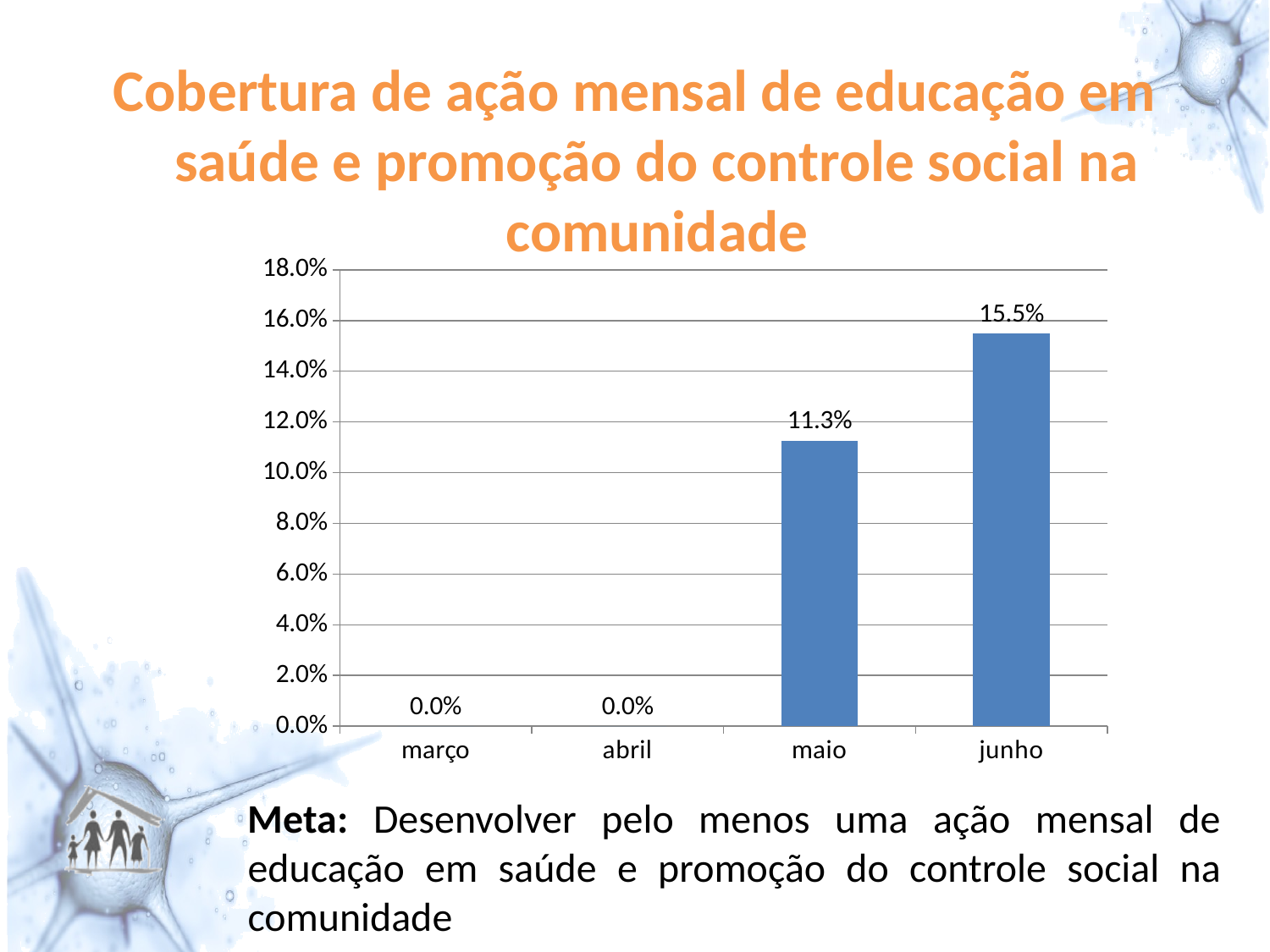
Which month has the highest value? junho How many months are shown on the x axis? 4 Which is larger, the value for maio or the value for junho? junho What is the value for maio? 11.3% Do the values rise or fall from março to junho? rise Is the value for maio greater or less than 10.0%? greater What kind of chart is shown on the slide? bar chart What is the value for junho? 15.5% What is the difference between the values for junho and maio? 4.2% What is the value for abril? 0.0% What is the value for março? 0.0% Is the value for junho greater or less than 16.0%? less